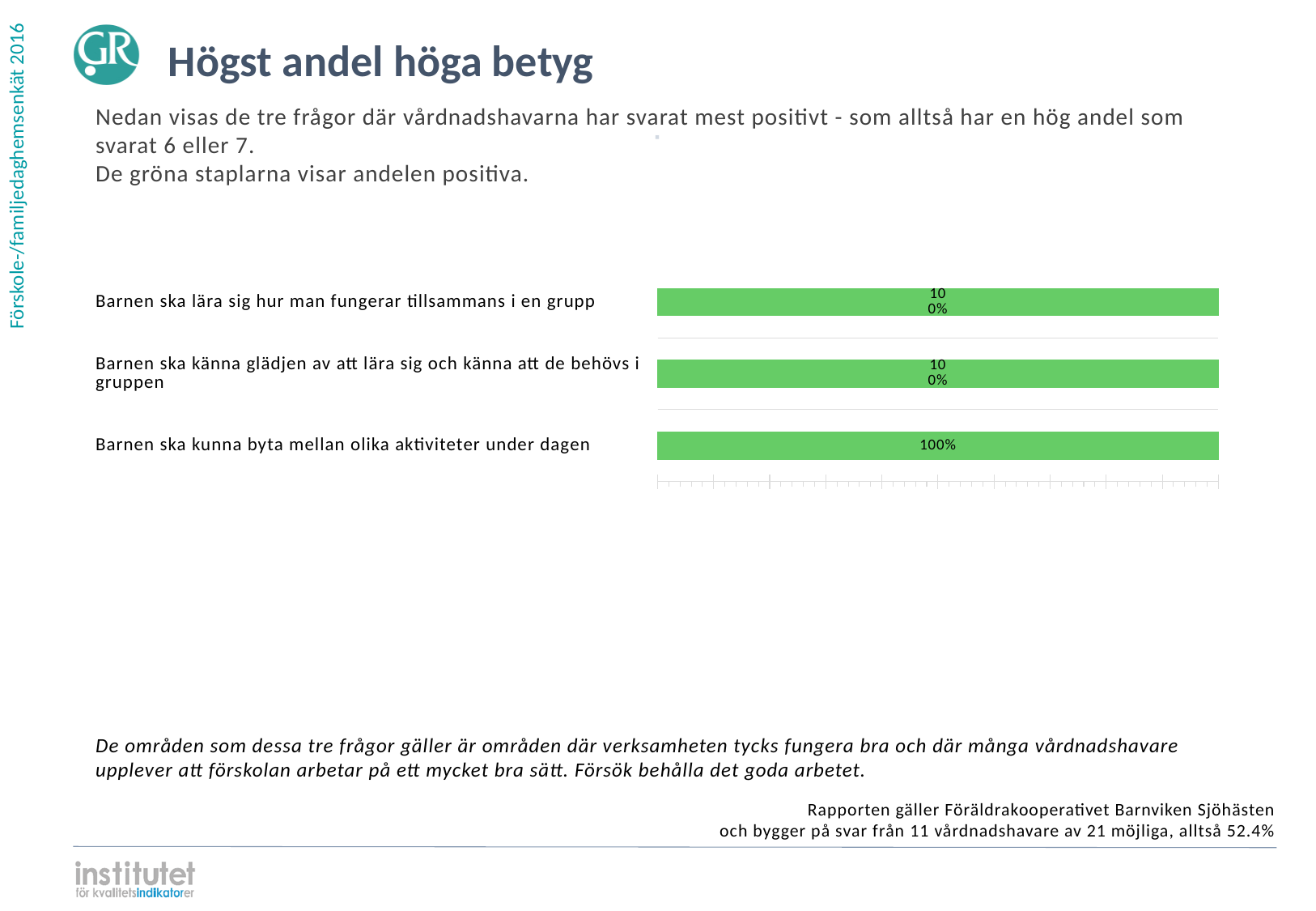
Do all three bars in the chart show the same value? Yes, 100% How many categories (questions) are plotted in the chart? 3 What kind of chart is shown on the slide? Bar chart What is the title of the slide containing the chart? Högst andel höga betyg What is the difference between the value for "Barnen ska kunna byta mellan olika aktiviteter under dagen" and the value for "Barnen ska lära sig hur man fungerar tillsammans i en grupp"? 0% What is the value shown for "Barnen ska lära sig hur man fungerar tillsammans i en grupp"? 100% Is the value for "Barnen ska kunna byta mellan olika aktiviteter under dagen" greater or less than 50%? greater What is the value shown for "Barnen ska kunna byta mellan olika aktiviteter under dagen"? 100% What colour are the bars in the chart? Green What is the value shown for "Barnen ska känna glädjen av att lära sig och känna att de behövs i gruppen"? 100%